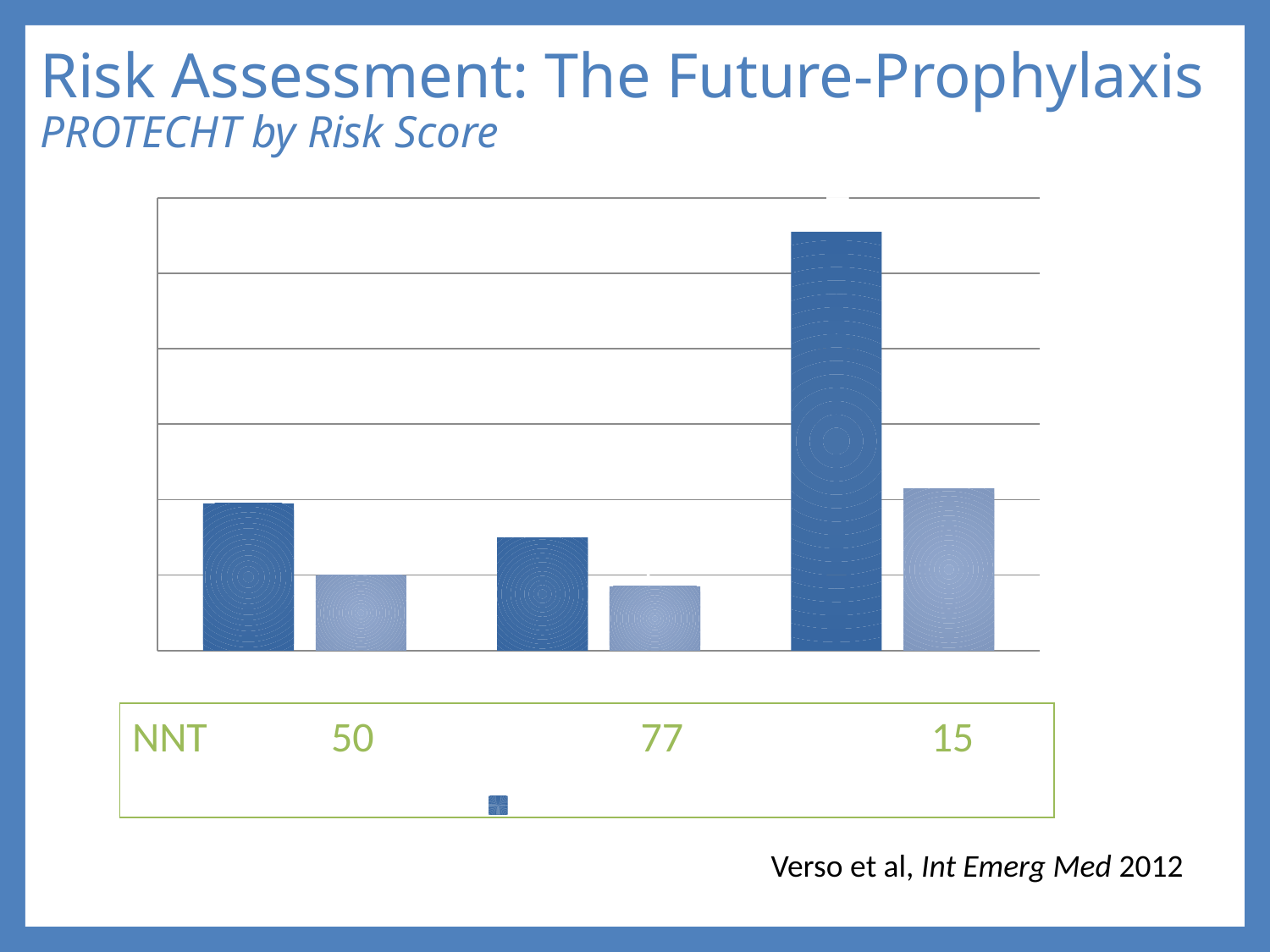
In the rightmost group, is the dark blue bar or the light blue bar taller? the dark blue bar Is the dark blue bar in the leftmost group taller or shorter than the dark blue bar in the middle group? taller How many bars are plotted in the chart? 6 How many groups of bars does the chart show? 3 In the leftmost group, is the dark blue bar or the light blue bar taller? the dark blue bar What is the subtitle of the chart slide? PROTECHT by Risk Score Which group of bars contains the tallest bar in the chart? the rightmost (third) group What NNT value is printed beneath the middle group of bars? 77 What NNT value is printed beneath the rightmost group of bars? 15 Do the dark blue bars rise steadily from left to right across the three groups? No What kind of chart is shown on the slide? bar chart Which group of bars contains the shortest bar in the chart? the middle (second) group